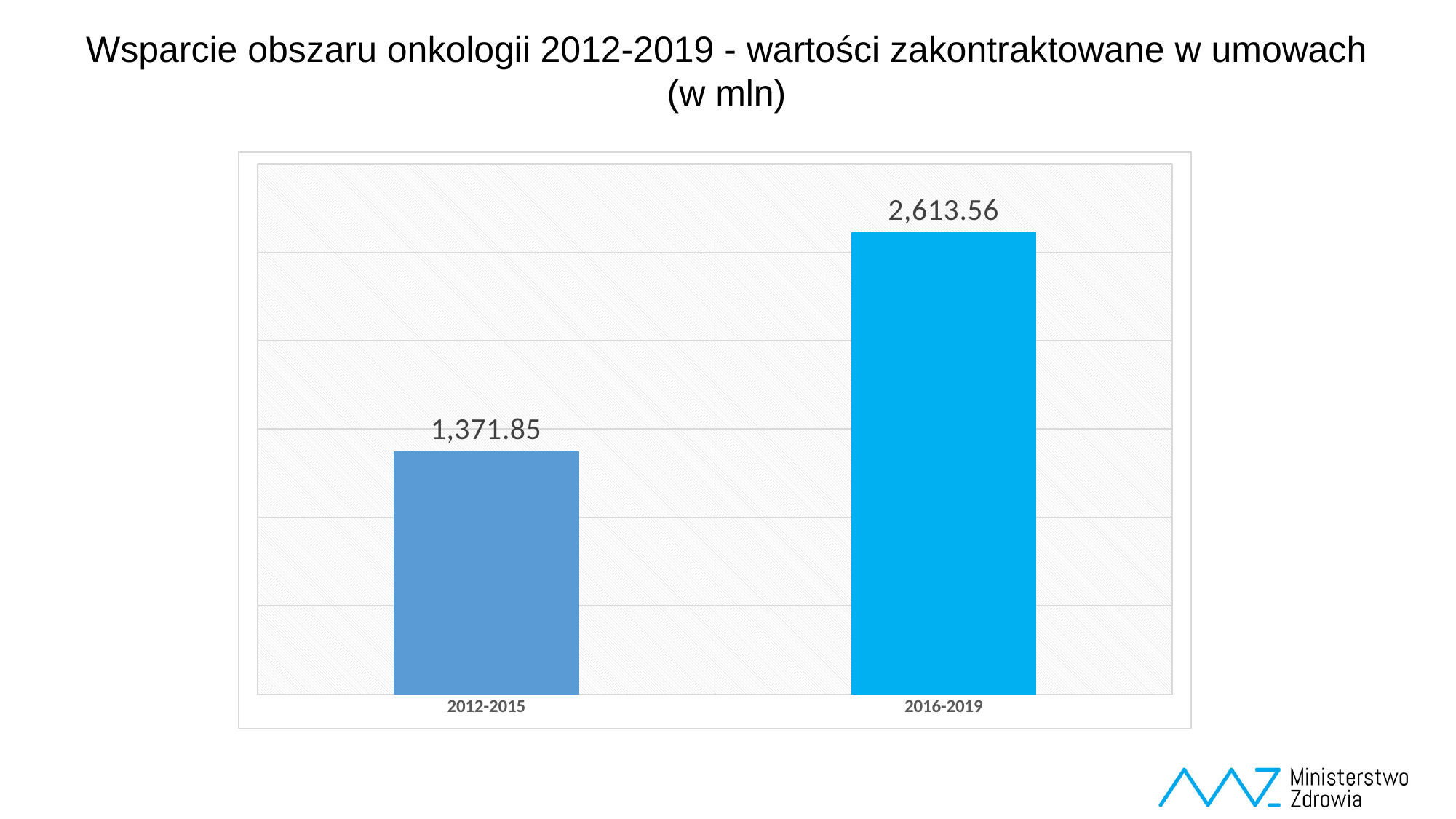
What unit is stated in the chart title? mln What is the title of the chart? Wsparcie obszaru onkologii 2012-2019 - wartości zakontraktowane w umowach (w mln) How many categories are shown on the x axis? 2 What is the difference between the values for 2016-2019 and 2012-2015? 1,241.71 What is the value for 2016-2019? 2,613.56 Do the values rise or fall from 2012-2015 to 2016-2019? Rise Which is larger, the value for 2012-2015 or the value for 2016-2019? 2016-2019 What is the value for 2012-2015? 1,371.85 Which period has the highest value? 2016-2019 Which period has the lowest value? 2012-2015 What kind of chart is shown on the slide? Bar chart